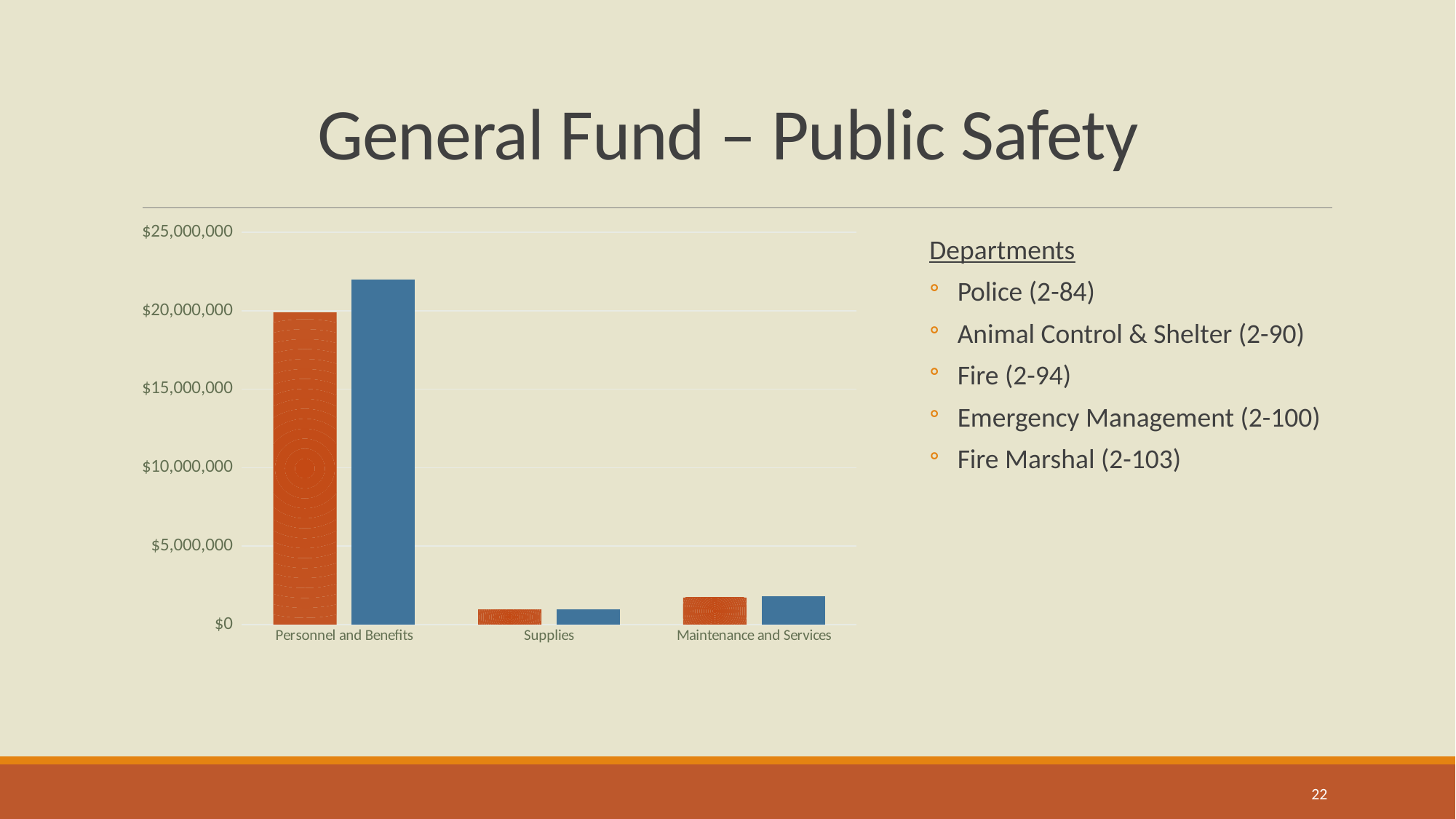
What is the highest value labelled on the vertical axis of the chart? $25,000,000 Is the value of the orange bar for Personnel and Benefits greater or less than $15,000,000? greater Which category has the highest bars in the chart? Personnel and Benefits Is the value of the blue bar for Maintenance and Services greater or less than $5,000,000? less For Personnel and Benefits, which bar is taller, the orange one or the blue one? the blue one Is the value of the orange bar for Supplies greater or less than $5,000,000? less What is the title of the slide containing the chart? General Fund – Public Safety How many categories are shown on the x axis of the chart? 3 Which category has larger values, Supplies or Maintenance and Services? Maintenance and Services Which category has the lowest bars in the chart? Supplies What kind of chart is shown on the slide? bar chart